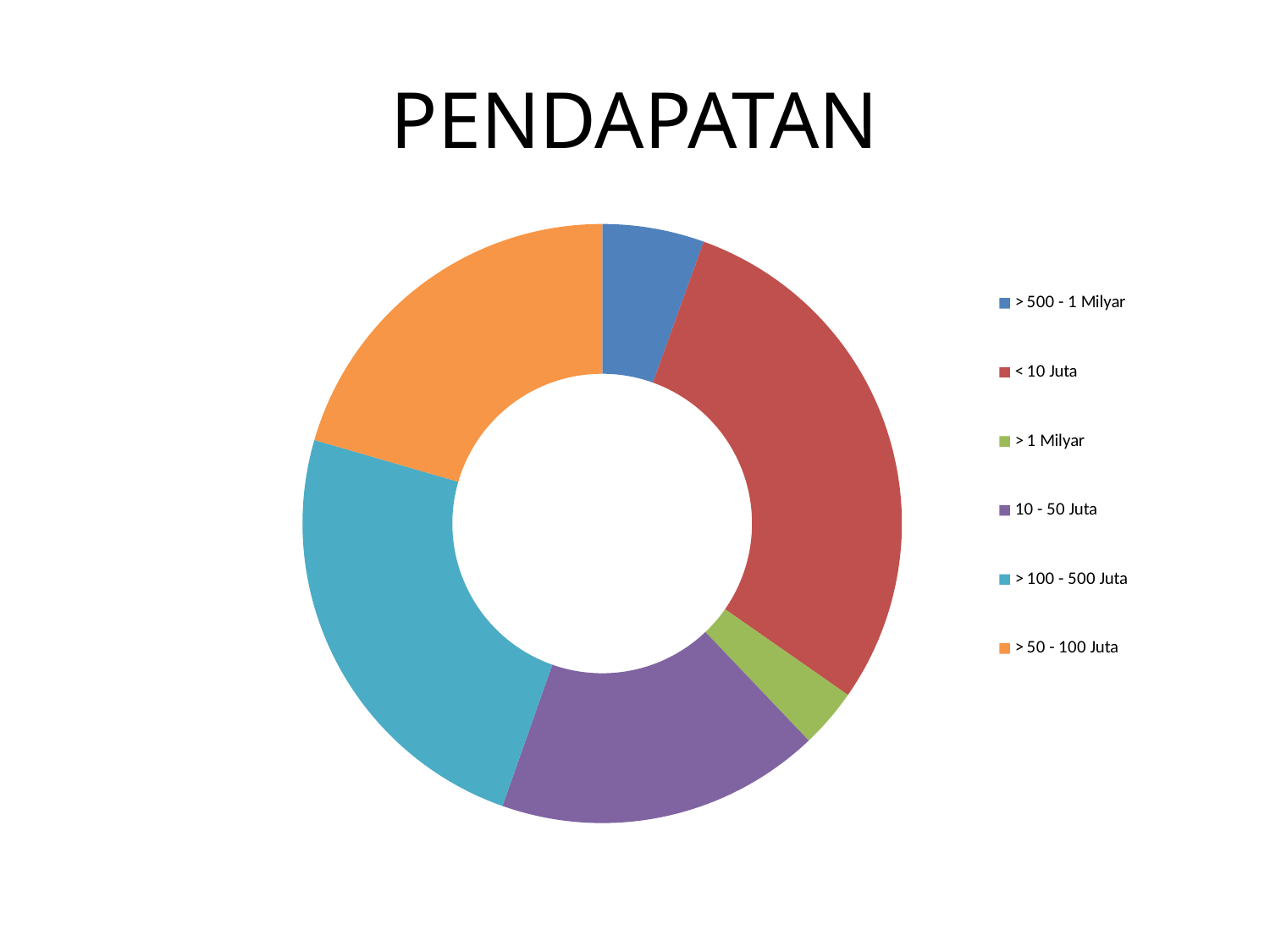
Which slice is larger: > 100 - 500 Juta or > 1 Milyar? > 100 - 500 Juta Which slice is larger: > 500 - 1 Milyar or > 1 Milyar? > 500 - 1 Milyar What is the title of the chart? PENDAPATAN Which slice is larger: < 10 Juta or > 100 - 500 Juta? < 10 Juta How many categories does the chart show? 6 What kind of chart is shown on the slide? Doughnut (pie) chart Which category has the smallest slice of the chart? > 1 Milyar Which category has the largest slice of the chart? < 10 Juta What colour represents the < 10 Juta category in the chart? Red